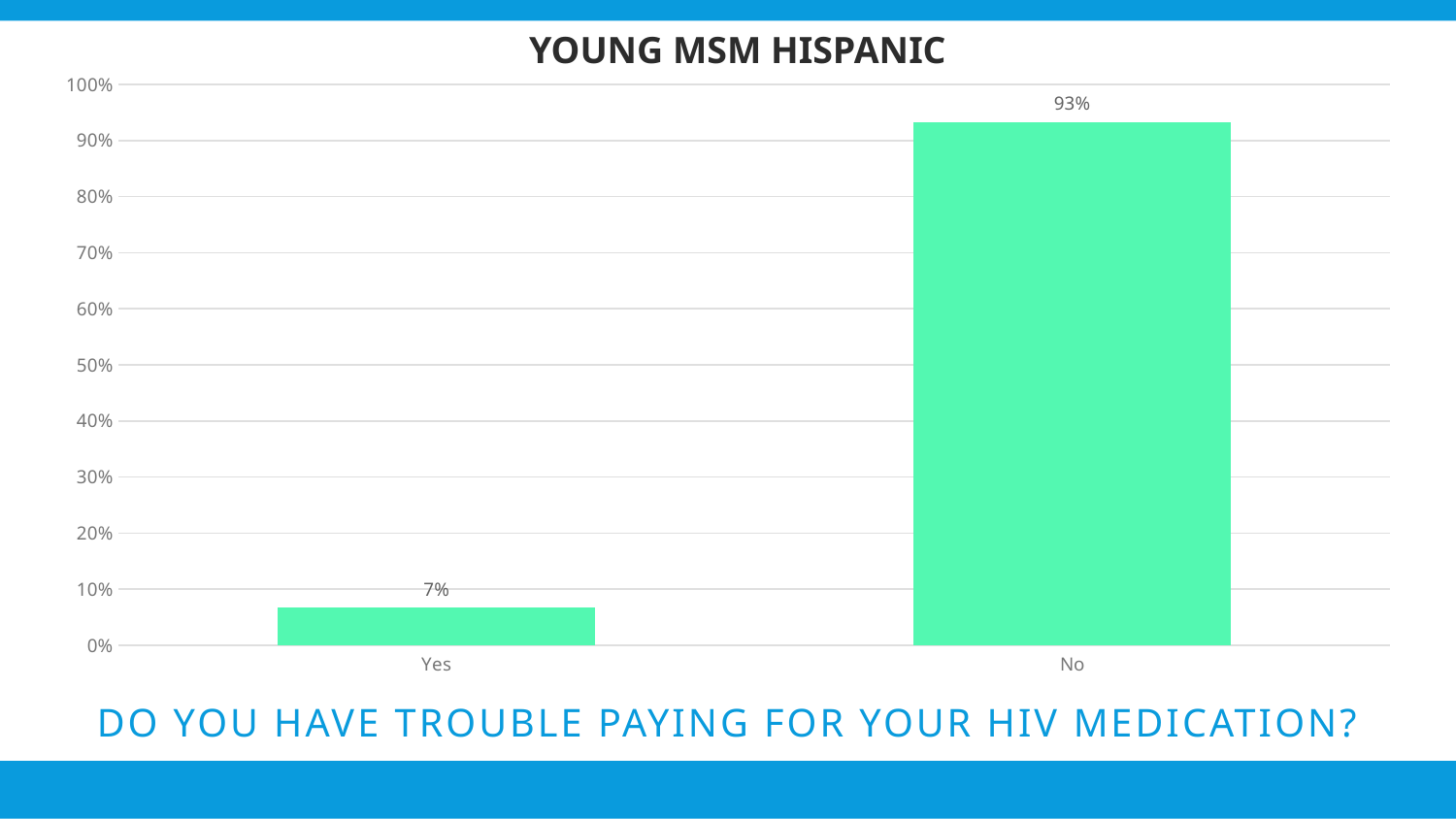
What is the title of the chart? YOUNG MSM HISPANIC Which category has the lowest value? Yes Is the value for "Yes" greater or less than 10%? less What is the value for "No"? 93% What is the highest value shown on the y axis? 100% How many categories are shown on the x axis? 2 Which is larger, the value for "Yes" or the value for "No"? No What is the difference between the values for "No" and "Yes"? 86% Which category has the highest value? No Is the value for "No" greater or less than 90%? greater What is the value for "Yes"? 7% What kind of chart is shown on the slide? bar chart